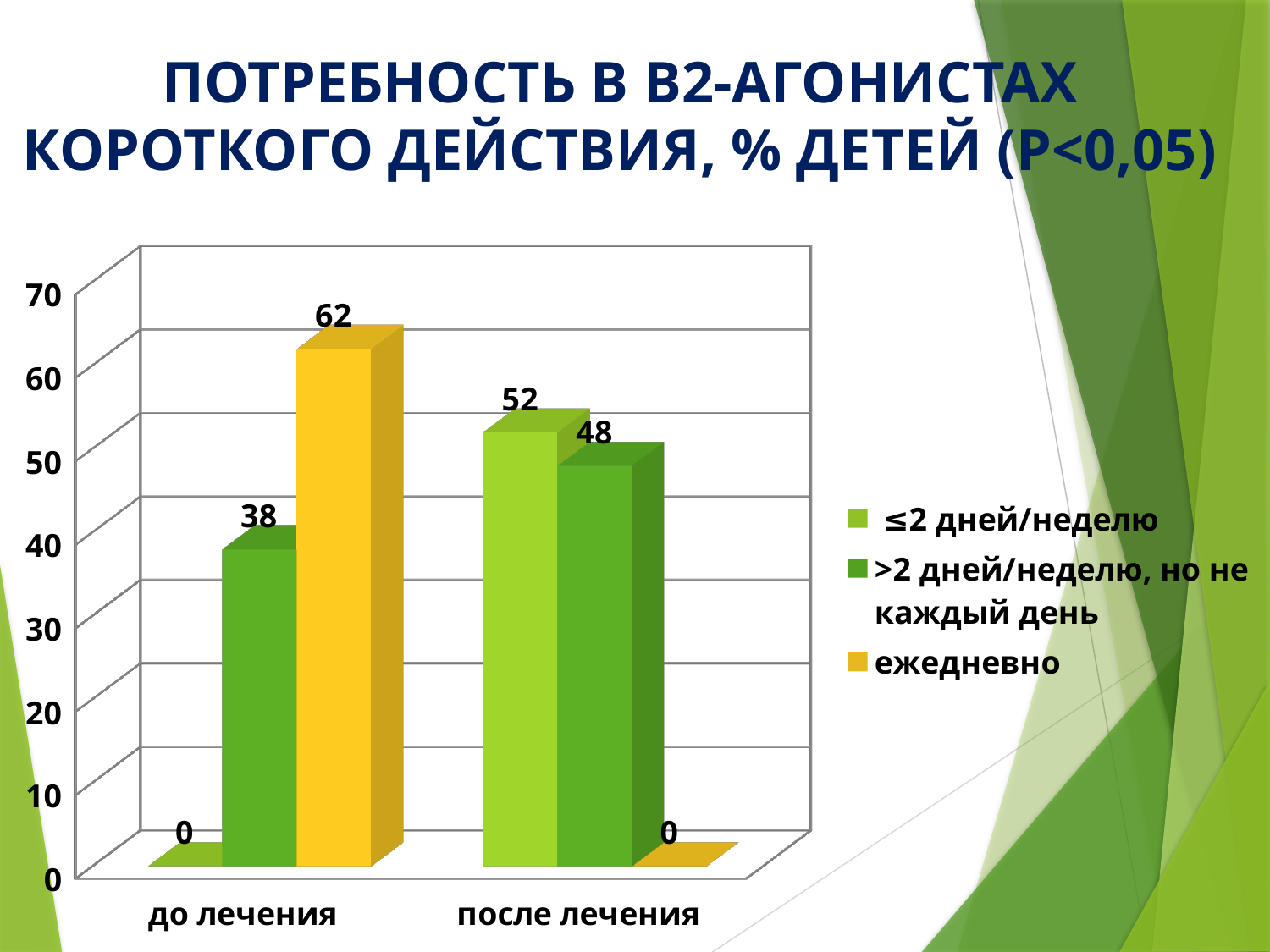
Which series has the highest value in the "до лечения" category? ежедневно How many series does the legend list? 3 How many categories are shown on the x axis? 2 What is the value for "ежедневно" in the "до лечения" category? 62 What is the value for "ежедневно" in the "после лечения" category? 0 What is the difference between the "≤2 дней/неделю" and ">2 дней/неделю, но не каждый день" values in the "после лечения" category? 4 What is the value for ">2 дней/неделю, но не каждый день" in the "до лечения" category? 38 What is the value for "≤2 дней/неделю" in the "после лечения" category? 52 What is the difference between the "ежедневно" value and the ">2 дней/неделю, но не каждый день" value in the "до лечения" category? 24 Which is larger: the "≤2 дней/неделю" value after treatment or the "ежедневно" value before treatment? ежедневно before treatment Which series has the lowest value in the "после лечения" category? ежедневно What kind of chart is shown on the slide? bar chart